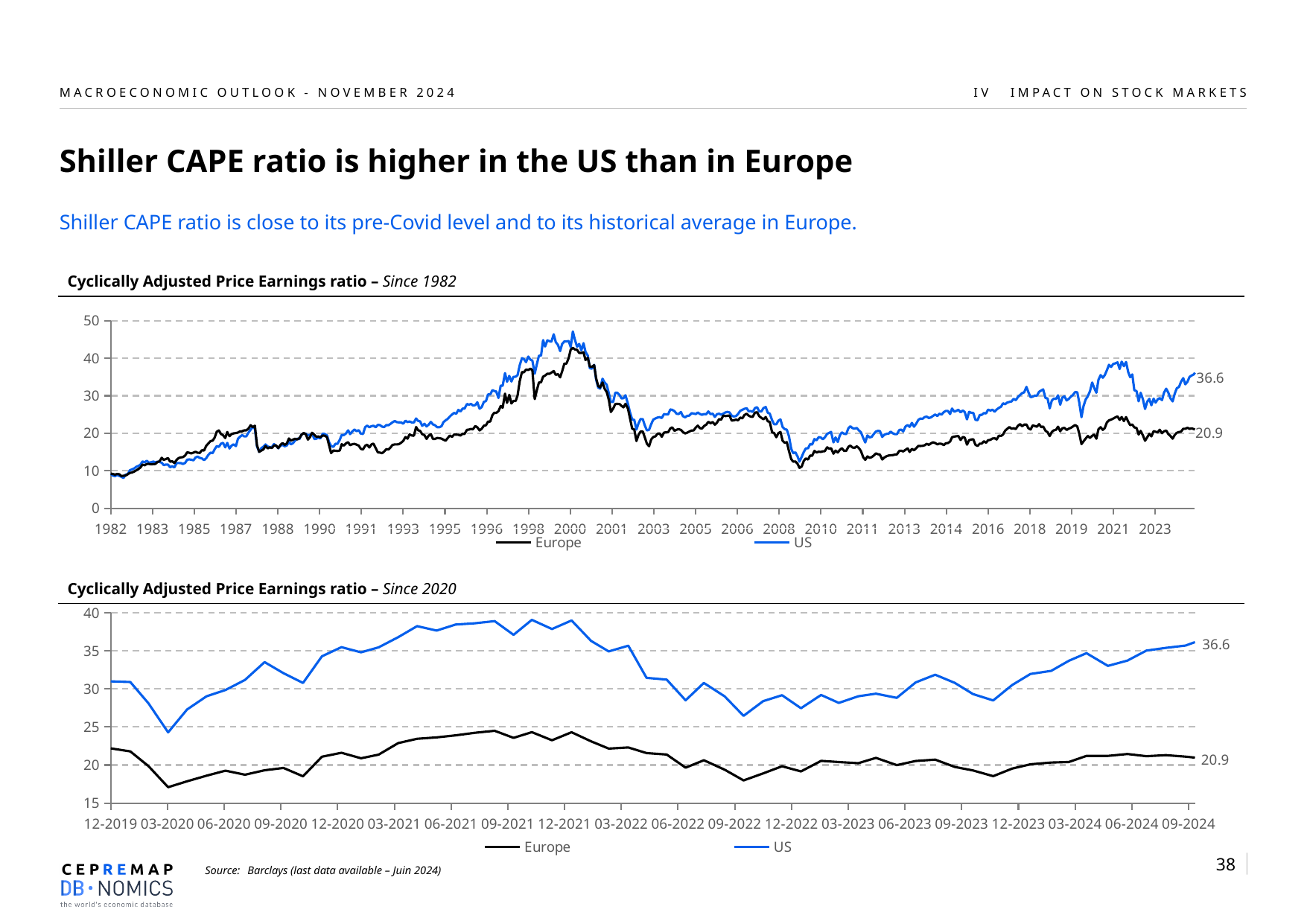
In the 'Since 2020' chart, does the US series rise or fall between 12-2021 and 09-2022? Fall In the 'Since 1982' chart, what is the latest value shown for the US series? 36.6 In the 'Since 2020' chart, which series has the higher latest value, US or Europe? US What kind of chart is the 'Since 1982' chart? Line chart In the 'Since 2020' chart, which colour is used for the Europe series? Black How many series does the legend of the 'Since 2020' chart list? 2 In the 'Since 2020' chart, what is the difference between the latest US value and the latest Europe value? 15.7 In the 'Since 2020' chart, is the US value at 03-2020 greater or less than 25? less In the 'Since 2020' chart, is the Europe value at 09-2021 greater or less than 20? greater In the 'Since 1982' chart, what is the latest value shown for the Europe series? 20.9 In the 'Since 1982' chart, is the US value around 2000 greater or less than 40? greater What is the title of the top chart on the slide? Cyclically Adjusted Price Earnings ratio – Since 1982